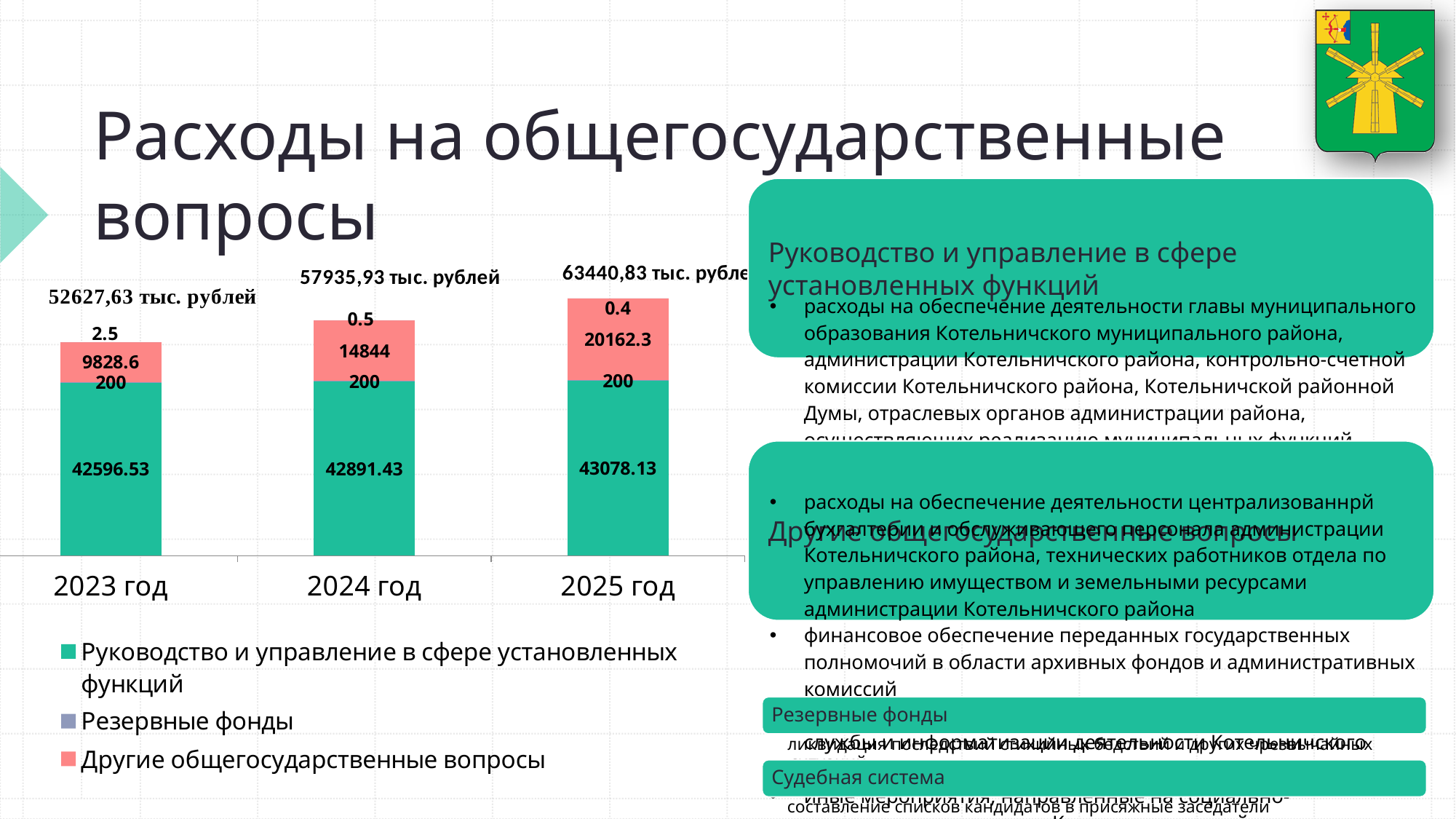
What is the total printed above the bar for 2025 год? 63440,83 тыс. рублей How many years (categories) are shown on the x axis of the chart? 3 Which year has the highest value for 'Другие общегосударственные вопросы'? 2025 год What is the value for 'Руководство и управление в сфере установленных функций' in 2025 год? 43078.13 How many series does the chart legend list? 3 What is the value for 'Резервные фонды' in 2024 год? 200 What is the value for 'Руководство и управление в сфере установленных функций' in 2023 год? 42596.53 Do the total values printed above the bars rise or fall from 2023 год to 2025 год? rise What kind of chart is shown on the slide? stacked bar chart What is the difference between the 'Другие общегосударственные вопросы' values for 2025 год and 2023 год? 10333.7 What is the value for 'Другие общегосударственные вопросы' in 2024 год? 14844 Which is larger: the 'Руководство и управление в сфере установленных функций' value for 2024 год or for 2023 год? 2024 год